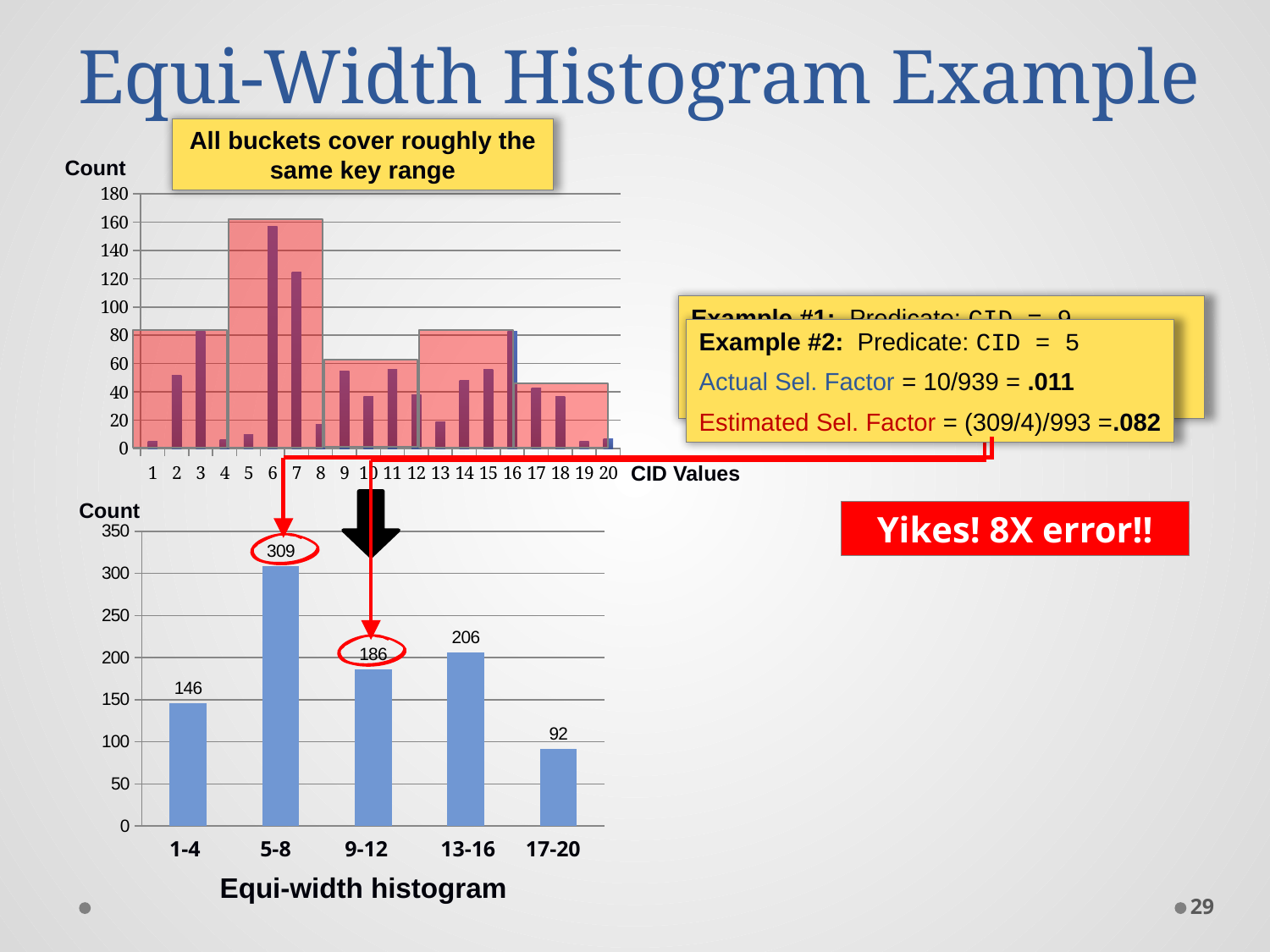
In the bottom chart (Equi-width histogram), which bucket has a larger count, 1-4 or 13-16? 13-16 In the bottom chart (Equi-width histogram), what is the count for the 17-20 bucket? 92 In the bottom chart (Equi-width histogram), which bucket has the highest count? 5-8 In the bottom chart (Equi-width histogram), what is the difference between the counts for the 5-8 and 1-4 buckets? 163 In the bottom chart (Equi-width histogram), what is the count for the 5-8 bucket? 309 In the bottom chart (Equi-width histogram), what is the difference between the counts for the 13-16 and 9-12 buckets? 20 In the top chart (CID Values), which CID value has the highest count? 6 In the top chart (CID Values), is the count for CID 6 greater or less than 140? greater In the top chart (CID Values), how many CID values are shown on the x axis? 20 What kind of chart is the bottom chart (Equi-width histogram)? bar chart In the bottom chart (Equi-width histogram), how many buckets are shown on the x axis? 5 In the bottom chart (Equi-width histogram), which bucket has the lowest count? 17-20